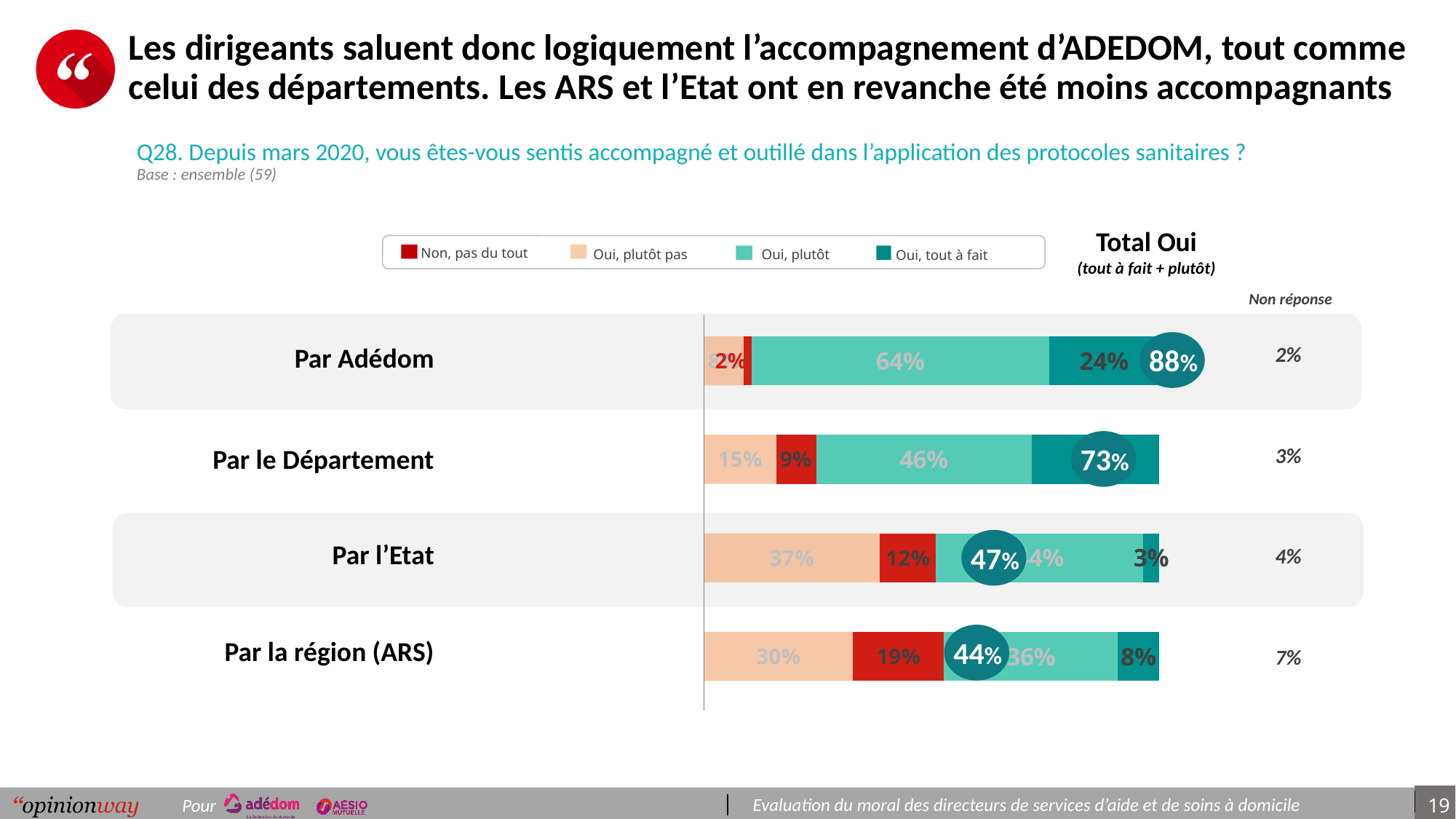
What is the 'Oui, plutôt pas' value for 'Par l'Etat'? 37% What is the 'Non, pas du tout' value for 'Par la région (ARS)'? 19% What kind of chart is shown on the slide? Stacked bar chart What is the difference between the 'Total Oui' values for 'Par Adédom' and 'Par la région (ARS)'? 44 points How many categories (rows) does the chart show? 4 What is the 'Total Oui' value for 'Par le Département'? 73% Which has the larger 'Non, pas du tout' value: 'Par l'Etat' or 'Par la région (ARS)'? Par la région (ARS) Which category has the lowest 'Total Oui' value? Par la région (ARS) Which category has the highest 'Total Oui' value? Par Adédom What is the 'Non réponse' value for 'Par l'Etat'? 4% How many series does the legend list? 4 What is the 'Oui, plutôt' value for 'Par Adédom'? 64%